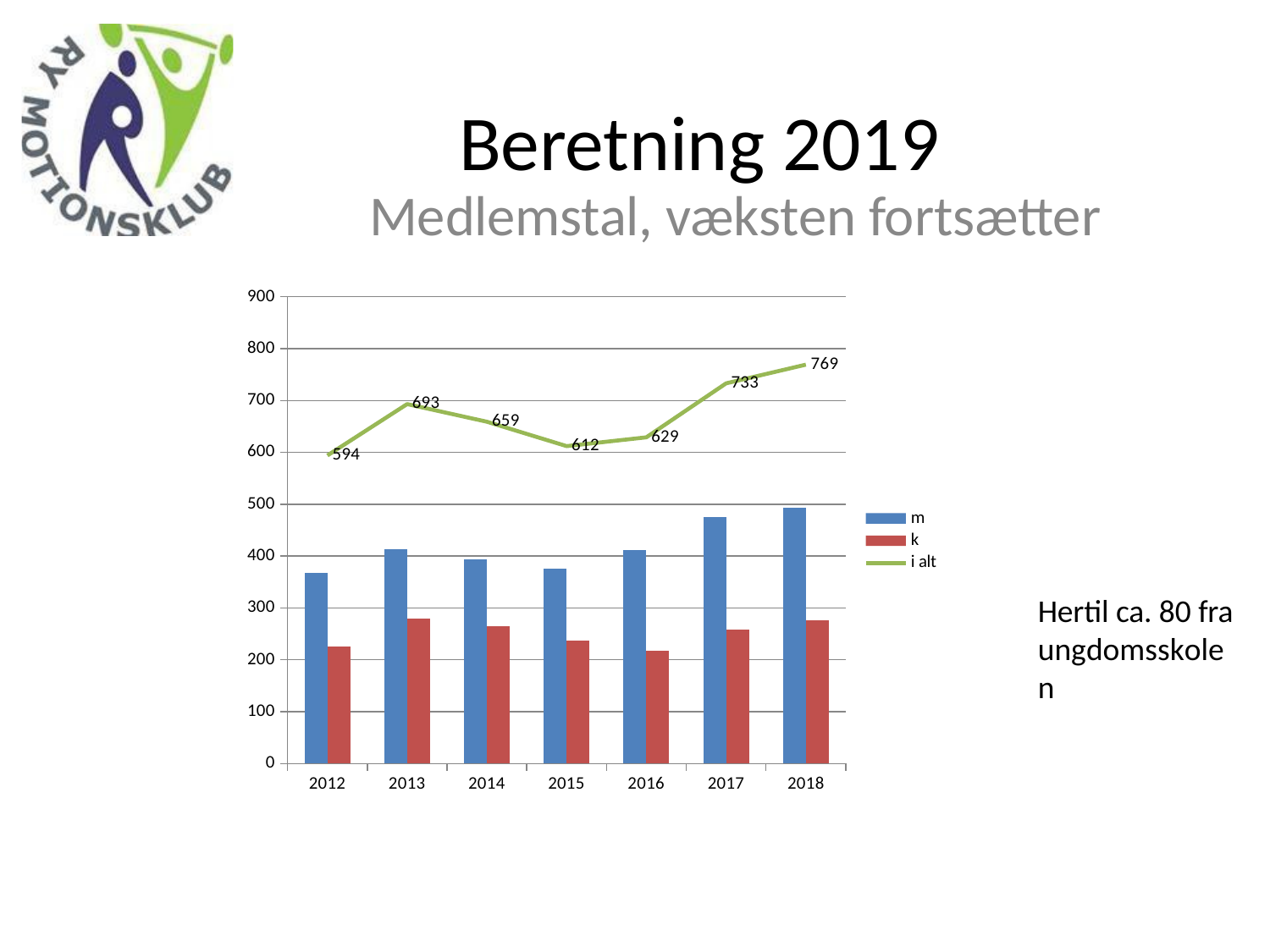
What is the value of the 'i alt' series for 2018? 769 In which year is the 'i alt' series lowest? 2012 Is the value of the 'k' series for 2013 greater or less than 300? less How many years are shown on the x axis? 7 Which is larger, the 'i alt' value for 2013 or for 2014? 2013 In which year is the 'i alt' series highest? 2018 What is the difference between the 'i alt' values for 2018 and 2017? 36 What is the value of the 'i alt' series for 2012? 594 Which series is drawn as a line rather than bars? i alt How many series does the legend list? 3 What is the value of the 'i alt' series for 2015? 612